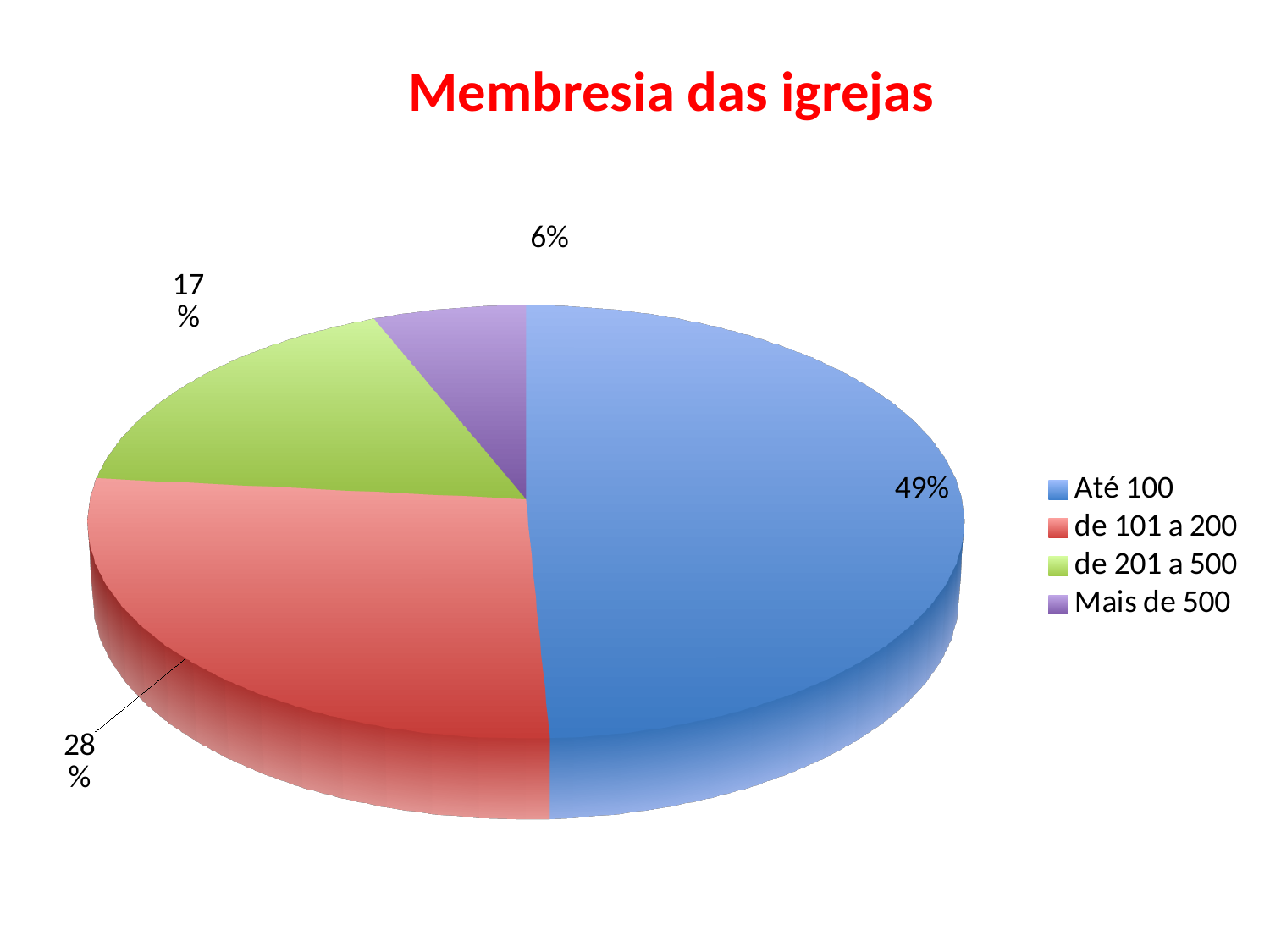
What kind of chart is shown on the slide? Pie chart What share of the pie does the 'Até 100' slice represent? 49% Which slice is larger, 'de 201 a 500' or 'Mais de 500'? de 201 a 500 What is the title of the chart? Membresia das igrejas What share of the pie does the 'Mais de 500' slice represent? 6% What share of the pie does the 'de 101 a 200' slice represent? 28% What colour is the 'de 201 a 500' slice? Green How many categories does the pie chart show? 4 Which category has the smallest slice of the pie? Mais de 500 Which category has the largest slice of the pie? Até 100 What is the difference in percentage points between the 'Até 100' slice and the 'de 101 a 200' slice? 21